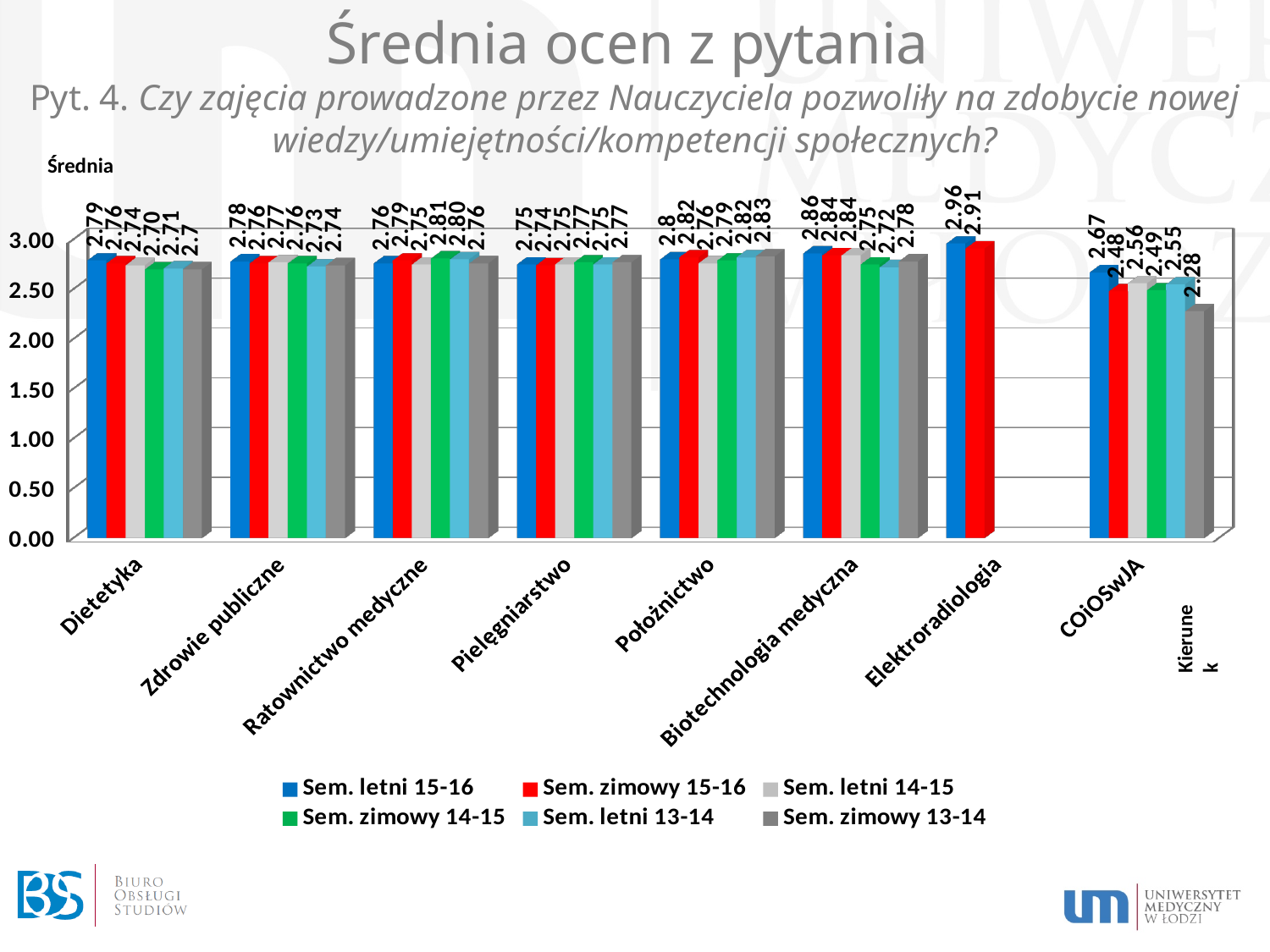
What is the value for COiOSwJA in the Sem. zimowy 13-14 series? 2.28 What is the value for Elektroradiologia in the Sem. zimowy 15-16 series? 2.91 Which colour represents the Sem. zimowy 14-15 series in the legend? green What is the value for Biotechnologia medyczna in the Sem. letni 13-14 series? 2.72 How many series does the legend list? 6 What is the difference between the Sem. letni 15-16 value for Elektroradiologia and the Sem. letni 15-16 value for COiOSwJA? 0.29 How many categories (kierunki) are shown on the x axis? 8 Which category has the highest value in the Sem. letni 15-16 series? Elektroradiologia What kind of chart is shown on the slide? bar chart Which is larger: the Sem. zimowy 15-16 value for COiOSwJA or the Sem. letni 14-15 value for COiOSwJA? Sem. letni 14-15 Which category has the lowest value in the Sem. zimowy 13-14 series? COiOSwJA What is the value for Dietetyka in the Sem. letni 15-16 series? 2.79